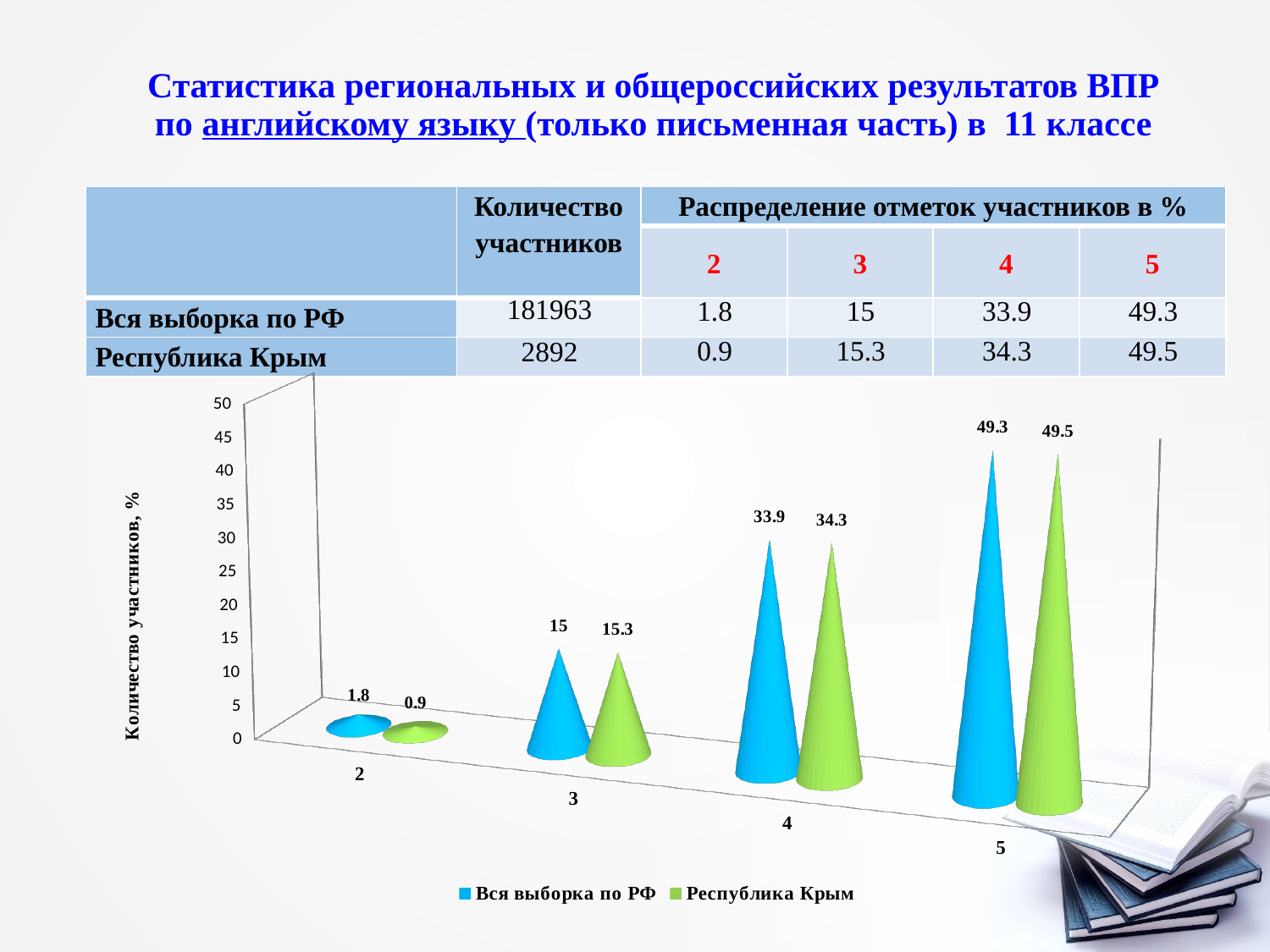
What is the difference between the "Вся выборка по РФ" and "Республика Крым" values at mark 2? 0.9 At mark 4, which series has the larger value: "Вся выборка по РФ" or "Республика Крым"? Республика Крым What is the value for "Вся выборка по РФ" at mark 3? 15 How many mark categories are shown on the x axis of the chart? 4 What is the value for "Вся выборка по РФ" at mark 4? 33.9 Which mark has the lowest value for "Вся выборка по РФ"? 2 Which mark has the highest value for "Республика Крым"? 5 What kind of chart is shown on the slide? bar chart What is the value for "Республика Крым" at mark 2? 0.9 Do the values for "Вся выборка по РФ" rise or fall as the mark increases from 2 to 5? rise How many series does the chart legend list? 2 What is the value for "Республика Крым" at mark 5? 49.5